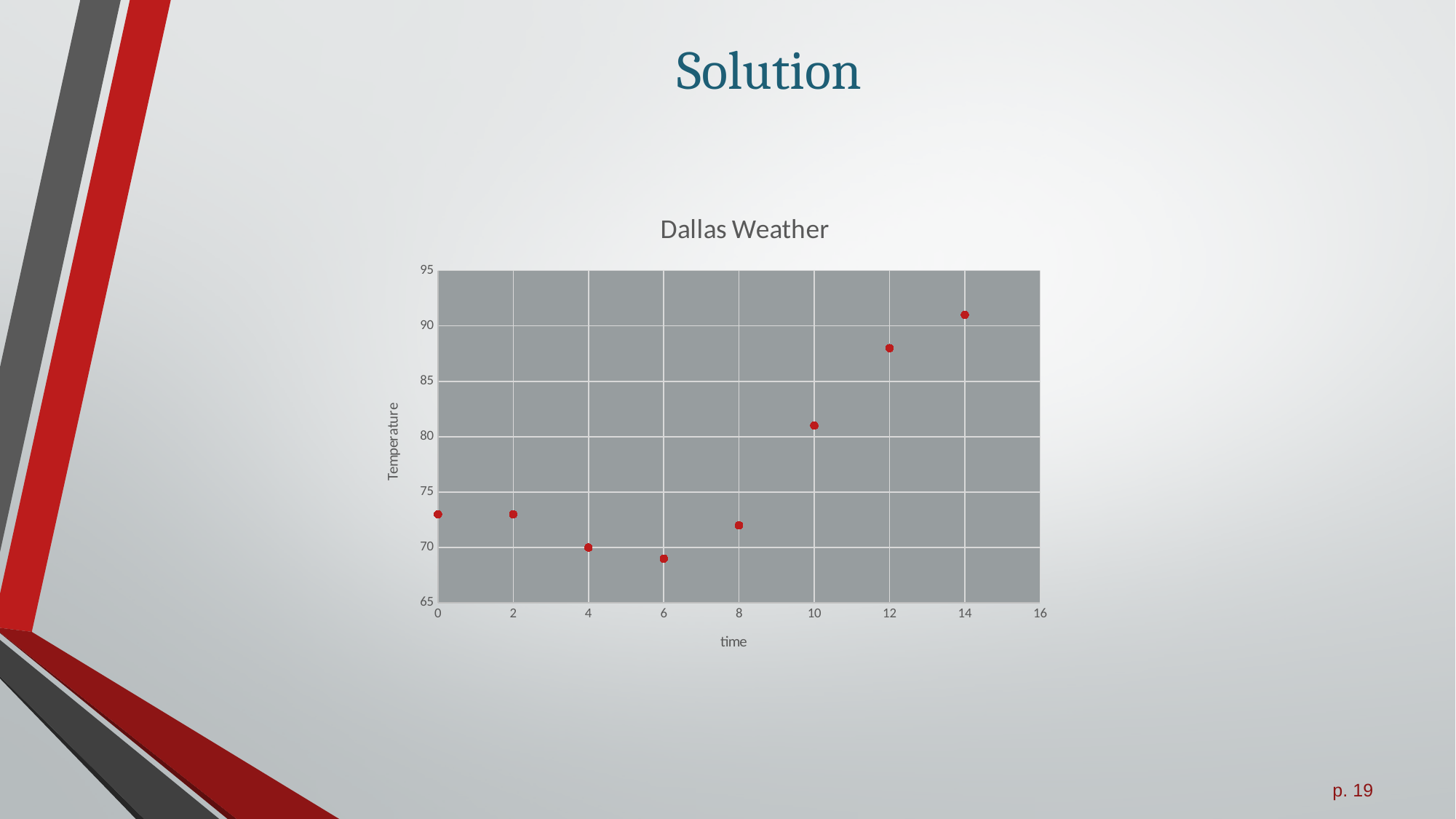
Is the Temperature at time 10 greater or less than 80? greater Is the Temperature at time 6 greater or less than 70? less What is the title of the chart? Dallas Weather Is the Temperature at time 14 greater or less than 90? greater How many data points are plotted in the chart? 8 What kind of chart is shown on the slide? scatter chart What is the label of the vertical axis? Temperature What is the Temperature value at time 4? 70 At which time is the Temperature highest? 14 Which is larger, the Temperature at time 12 or at time 8? time 12 At which time is the Temperature lowest? 6 Do the Temperature values rise or fall between time 8 and time 14? rise